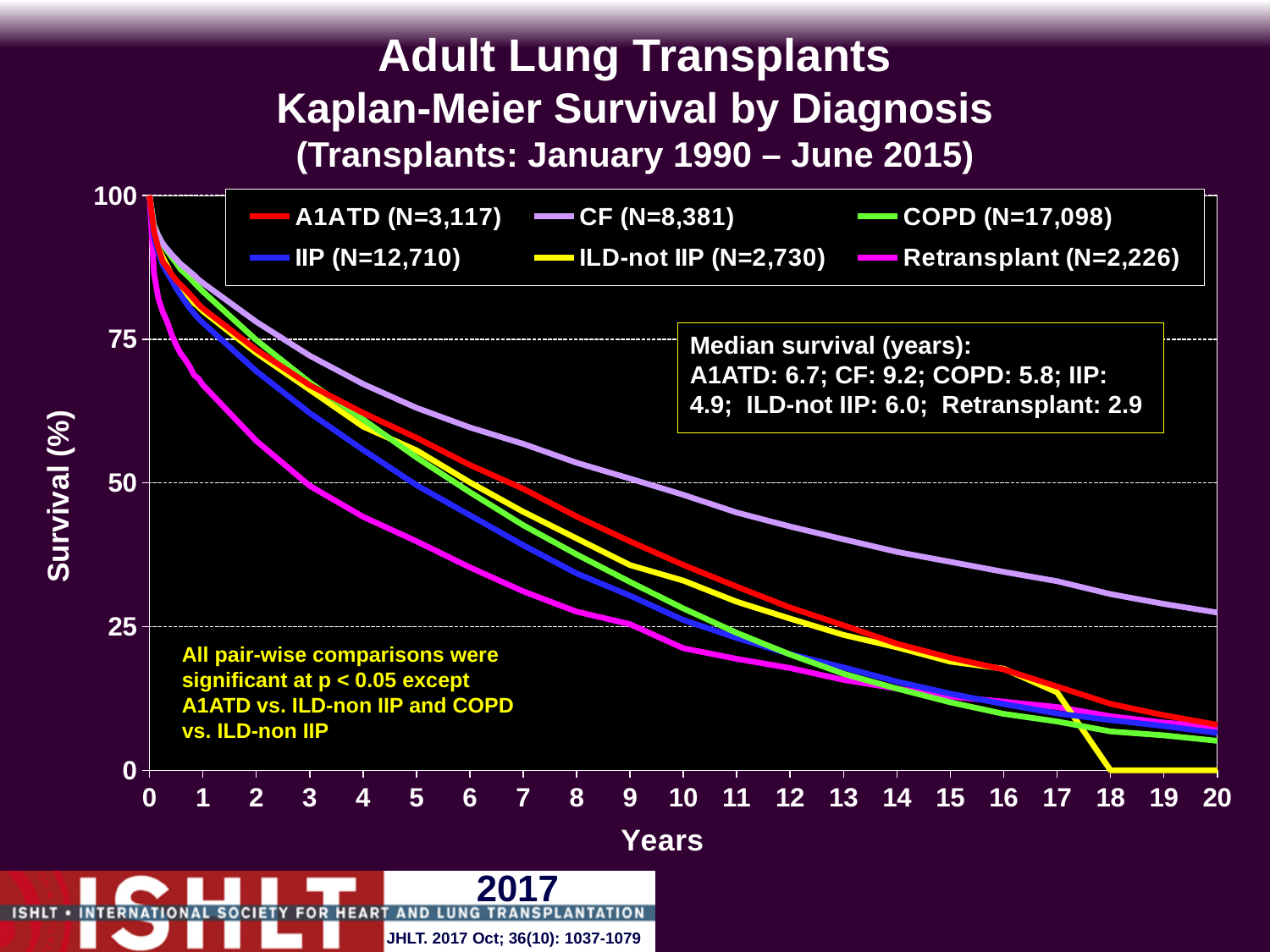
What kind of chart is shown on the slide? Line chart What is the median survival in years for CF according to the text box? 9.2 Which diagnosis has the highest median survival? CF Which series has the highest survival at 20 years? CF Do the survival curves rise or fall as years increase? Fall Which diagnosis has the lowest median survival? Retransplant Which has the larger median survival, A1ATD or IIP? A1ATD What is the difference in median survival (years) between CF and COPD? 3.4 What is the N for COPD shown in the legend? 17,098 How many series does the legend list? 6 Is the survival for CF at 15 years greater or less than 25? greater Is the survival for Retransplant at 5 years greater or less than 50? less